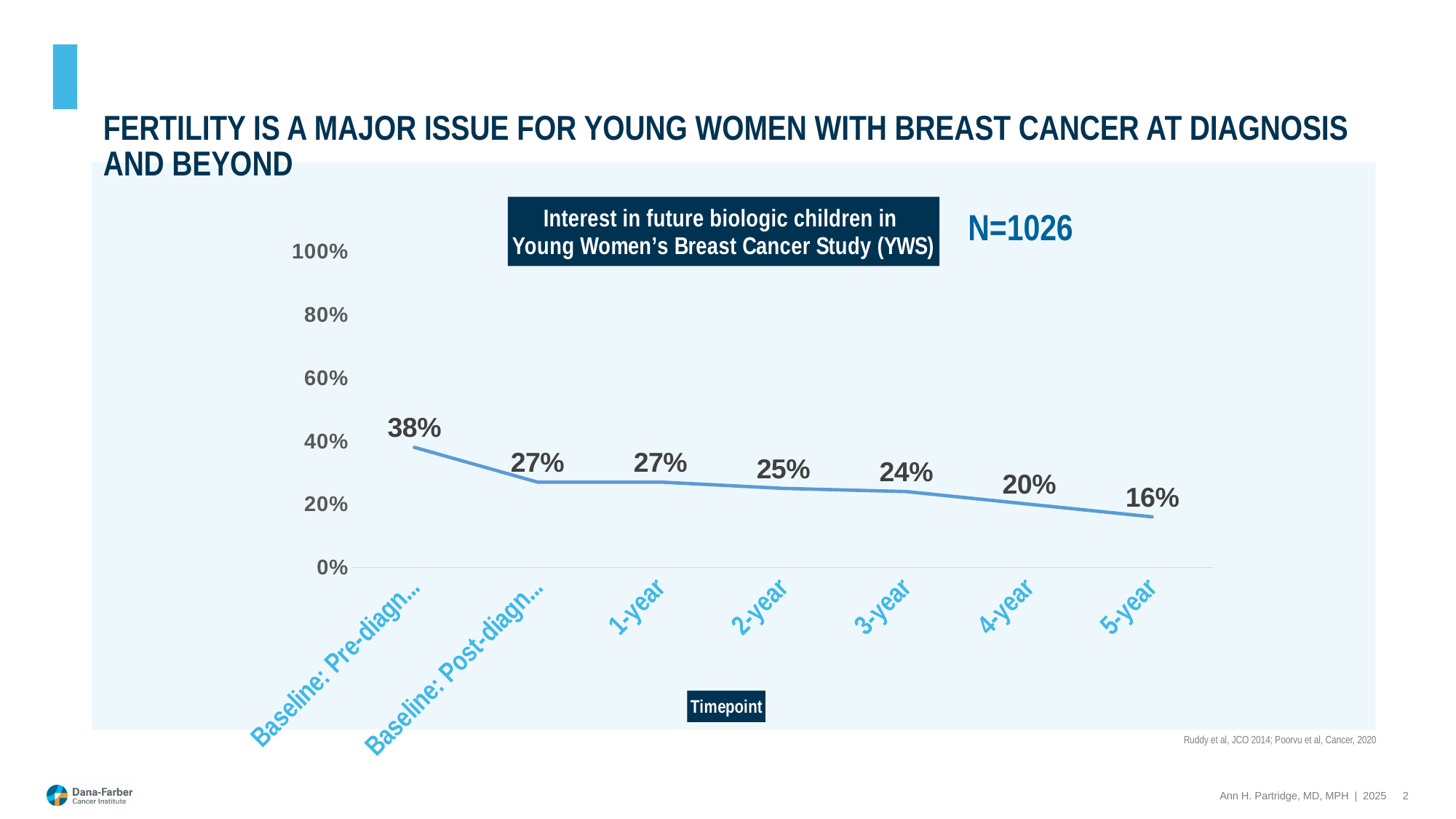
What is the difference between the Baseline: Pre-diagn... value and the 5-year value? 22% What kind of chart is shown on the slide? Line chart Do the values rise or fall from the first timepoint to the last? Fall Which timepoint has the lowest value? 5-year Which is larger, the value at 3-year or the value at 4-year? 3-year What is the difference between the 2-year value and the 4-year value? 5% What is the title of the chart? Interest in future biologic children in Young Women's Breast Cancer Study (YWS) Which timepoint has the highest value? Baseline: Pre-diagn... What is the value at the 5-year timepoint? 16% What is the value at the 1-year timepoint? 27% What is the value at the 3-year timepoint? 24% How many timepoints are plotted on the chart? 7